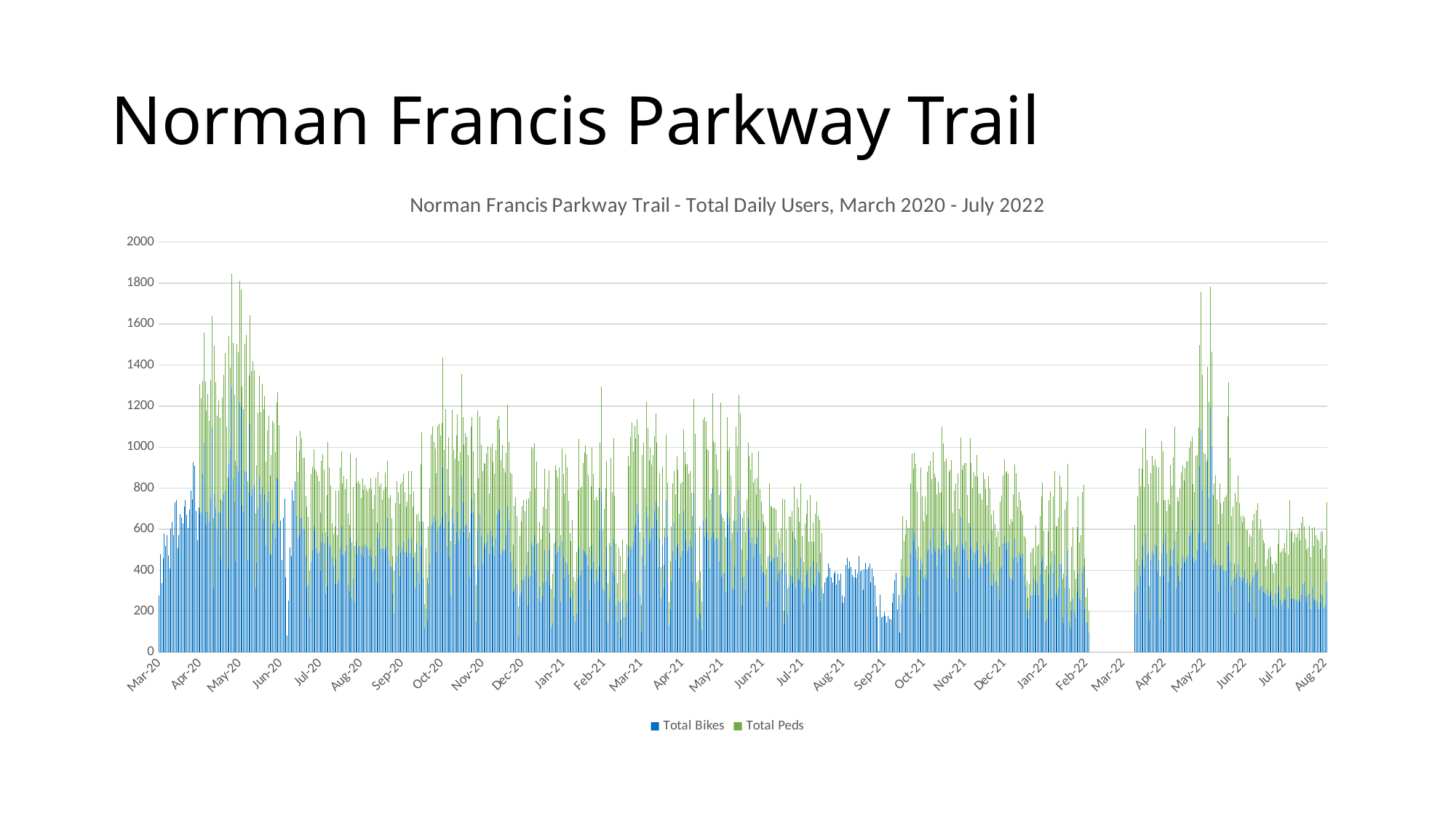
Are the tallest stacked bars around May-20 greater or less than 1600? greater What is the title of the chart? Norman Francis Parkway Trail - Total Daily Users, March 2020 - July 2022 Which period has taller stacked bars, around May-20 or around Sep-21? May-20 How many series does the legend list? 2 What type of chart is shown on the slide? bar chart How many month labels are shown along the x axis? 30 Which month label on the x axis has no bars plotted around it? Mar-22 What is the highest value shown on the y axis? 2000 What is the interval between consecutive y-axis tick labels? 200 Does any stacked bar reach the 2000 gridline? no Do the stacked daily totals rise or fall from Jul-21 to Sep-21? fall Are the stacked daily totals around Sep-21 greater or less than 400? less